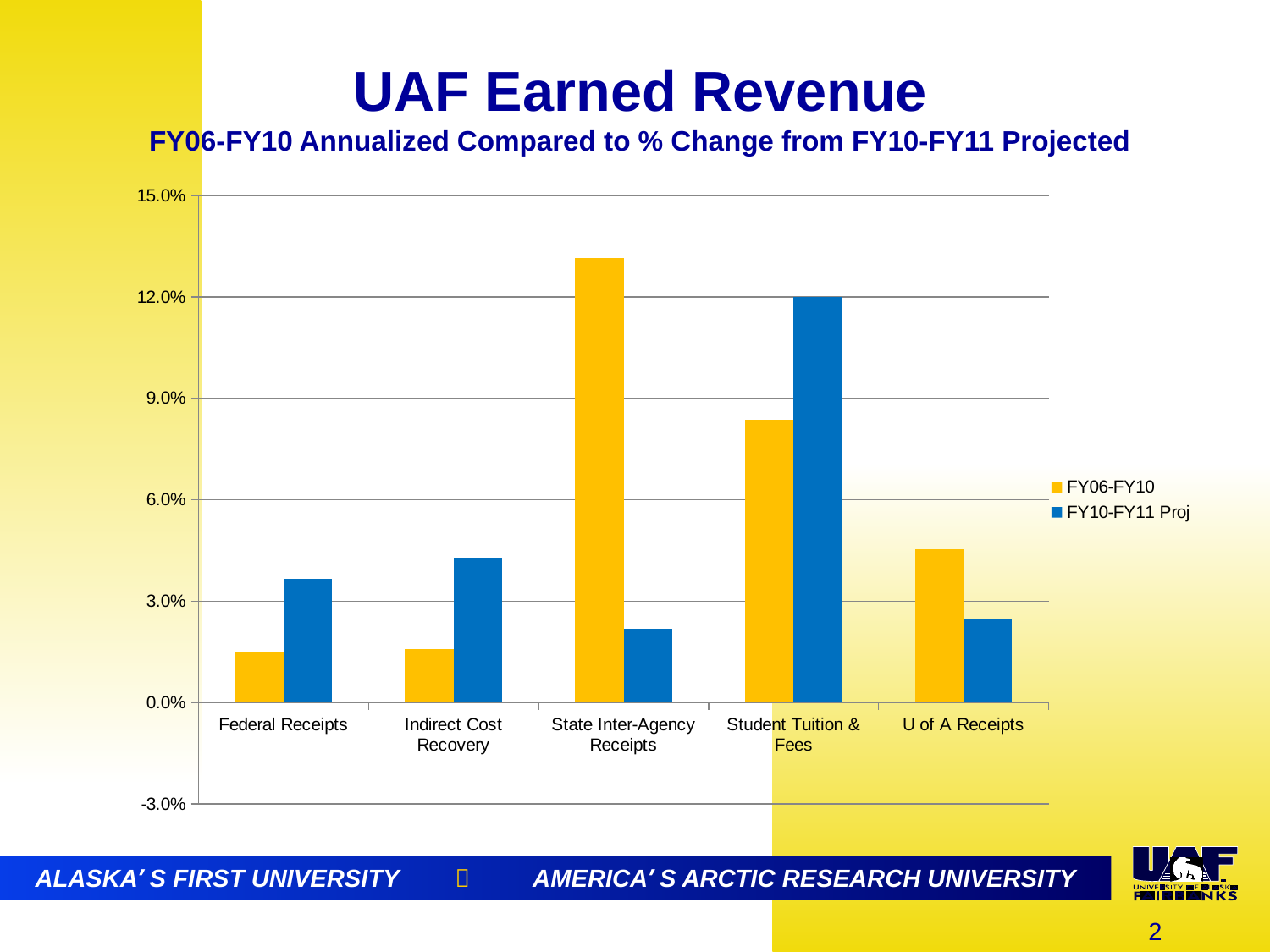
How many series does the legend list? 2 Is the FY06-FY10 value for Student Tuition & Fees greater or less than 9.0%? less Is the FY06-FY10 value for State Inter-Agency Receipts greater or less than 12.0%? greater How many revenue categories are shown on the x axis? 5 Is the FY10-FY11 Proj value for Federal Receipts greater or less than 3.0%? greater For Federal Receipts, which is larger: the FY06-FY10 value or the FY10-FY11 Proj value? FY10-FY11 Proj For State Inter-Agency Receipts, which is larger: the FY06-FY10 value or the FY10-FY11 Proj value? FY06-FY10 What kind of chart is shown on the slide? Bar chart Which category has the highest FY10-FY11 Proj value? Student Tuition & Fees What are the two series named in the legend? FY06-FY10 and FY10-FY11 Proj Which category has the highest FY06-FY10 value? State Inter-Agency Receipts